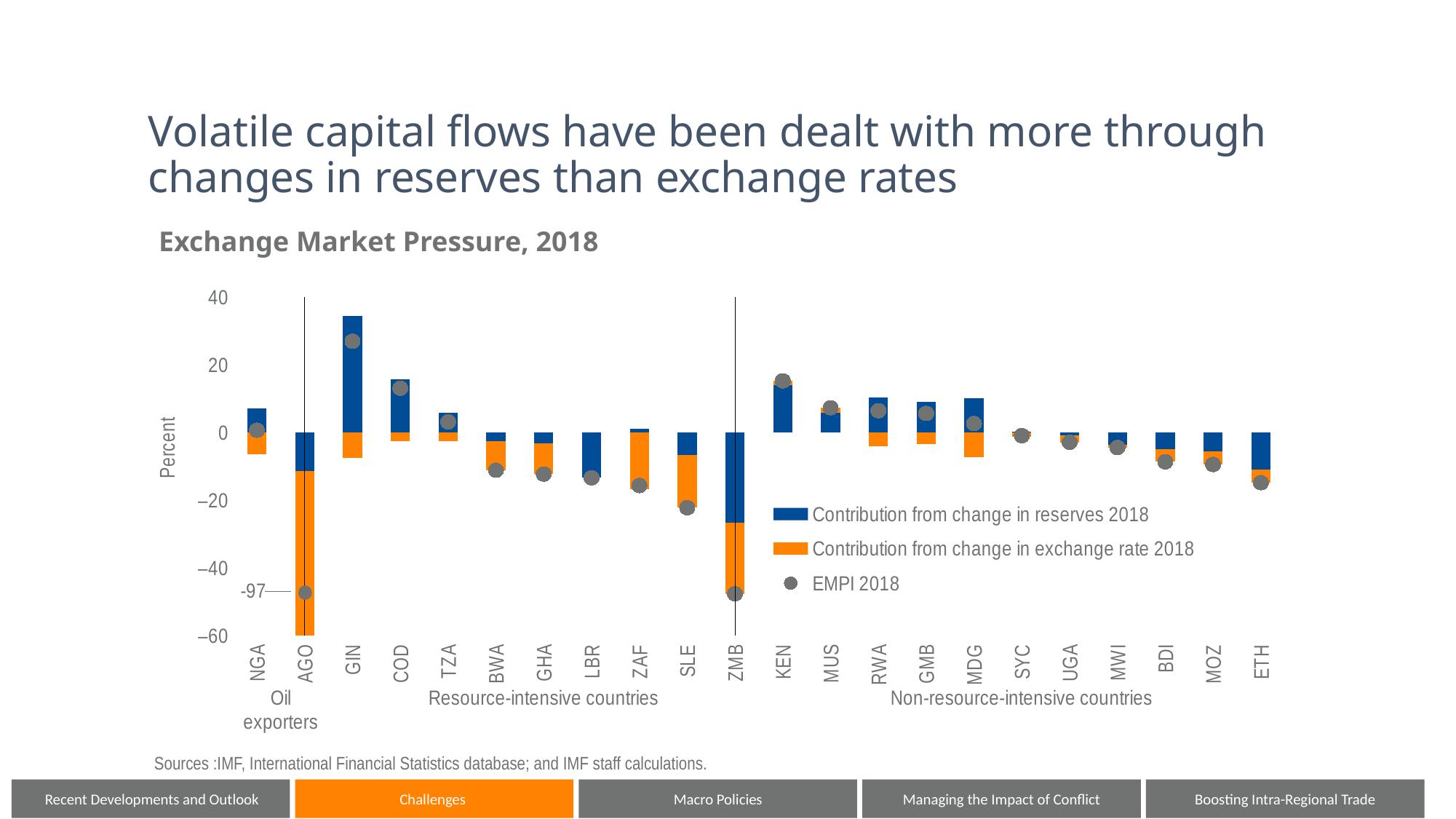
What is the EMPI 2018 value for AGO? -97 Is the EMPI 2018 value for ZMB greater or less than -40? less Is the EMPI 2018 value for LBR greater or less than -20? greater Which has the larger EMPI 2018 value, GIN or COD? GIN Is the contribution from change in reserves 2018 for GIN greater or less than 20? greater What kind of chart is shown on the slide? bar chart Which has the larger EMPI 2018 value, KEN or MUS? KEN How many series does the legend list? 3 What is the title of the chart? Exchange Market Pressure, 2018 Which country has the lowest EMPI 2018 value? AGO Which country has the highest EMPI 2018 value? GIN How many countries are shown on the x axis of the chart? 22